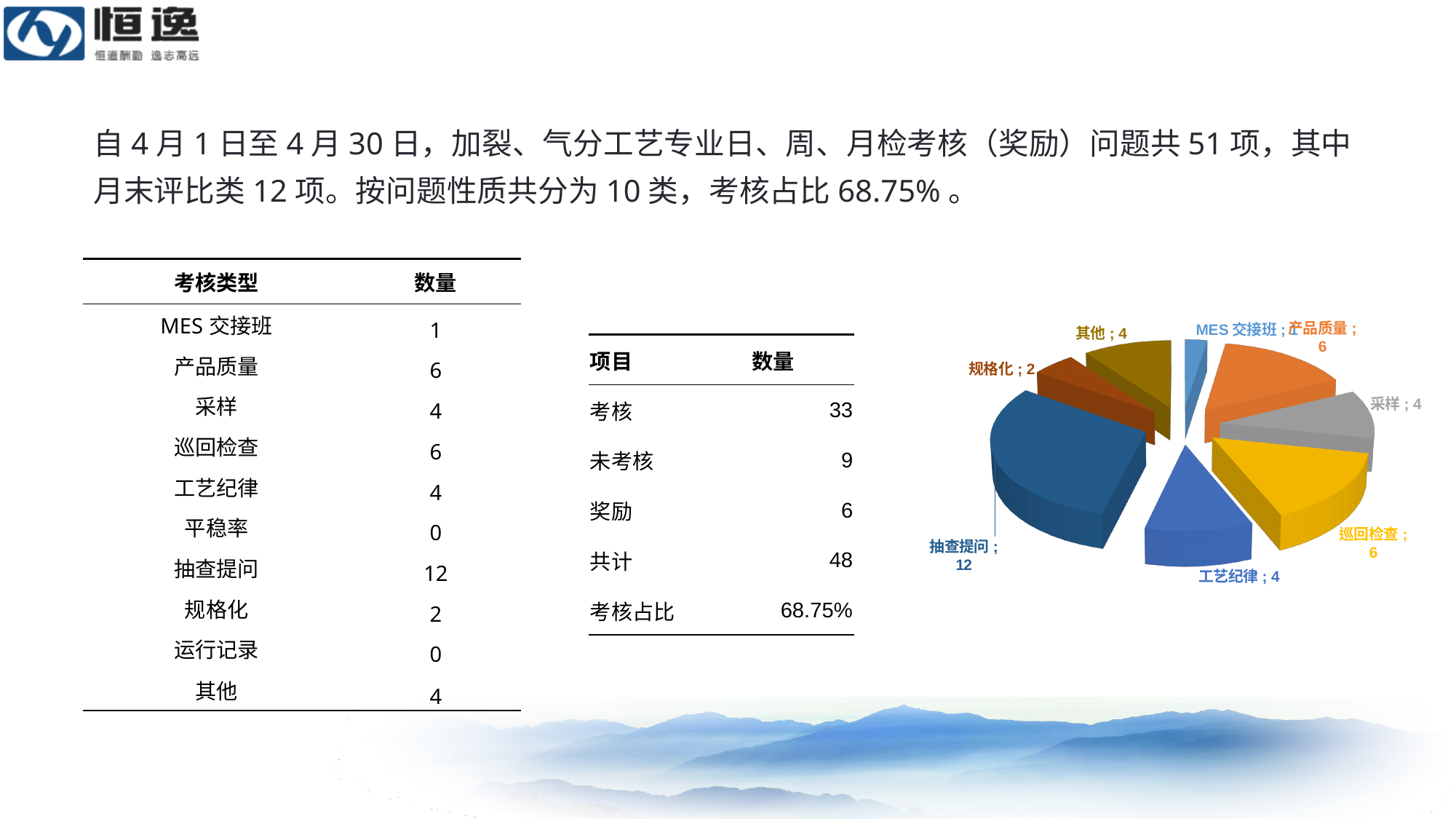
Which category has the smallest slice in the pie chart? MES 交接班 In the pie chart, what is the difference between the values for 巡回检查 and 工艺纪律? 2 In the pie chart, what is the value for 巡回检查? 6 What colour is the 抽查提问 slice in the pie chart? dark blue Which category has the largest slice in the pie chart? 抽查提问 What kind of chart is shown on the right side of the slide? pie chart In the pie chart, what is the value for 规格化? 2 In the pie chart, which is larger, the value for 产品质量 or the value for 采样? 产品质量 In the pie chart, what is the difference between the values for 抽查提问 and 规格化? 10 How many slices does the pie chart have? 8 In the pie chart, what is the value for 抽查提问? 12 In the pie chart, what is the value for 其他? 4